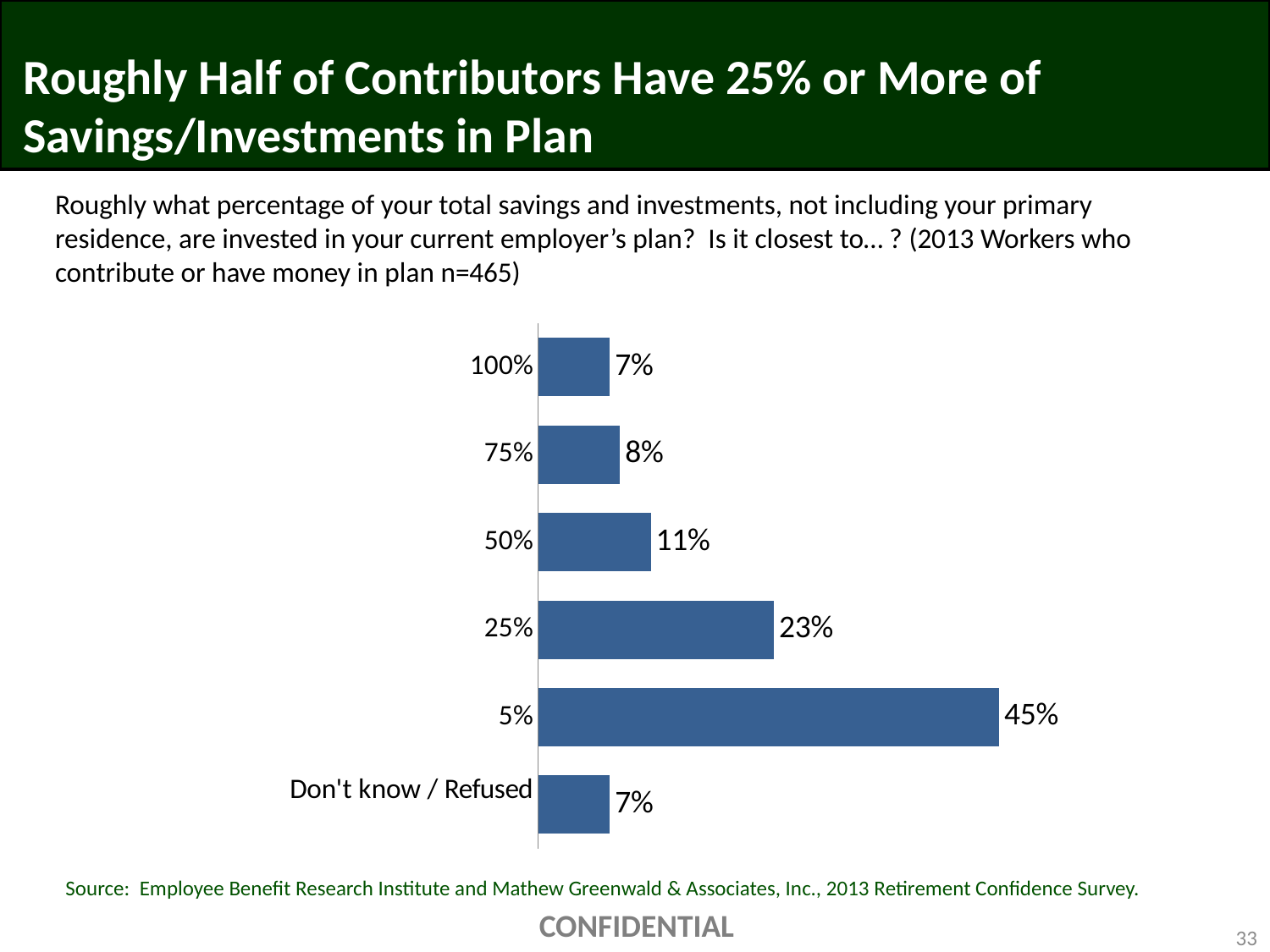
What value is shown for the 75% category? 8% What is the sample size (n) stated in the question text above the chart? 465 Which is larger, the value for the 50% category or the value for the 75% category? 50% Which category has the highest value? 5% What value is shown for the Don't know / Refused category? 7% What is the difference between the values for the 5% and 25% categories? 22 percentage points What percentage of contributors said 5% of their savings/investments are in the plan? 45% What kind of chart is shown on the slide? Bar chart What value is shown for the 25% category? 23% What value is shown for the 50% category? 11% How many categories are shown on the chart? 6 What is the combined value of the 100% and 75% categories? 15%